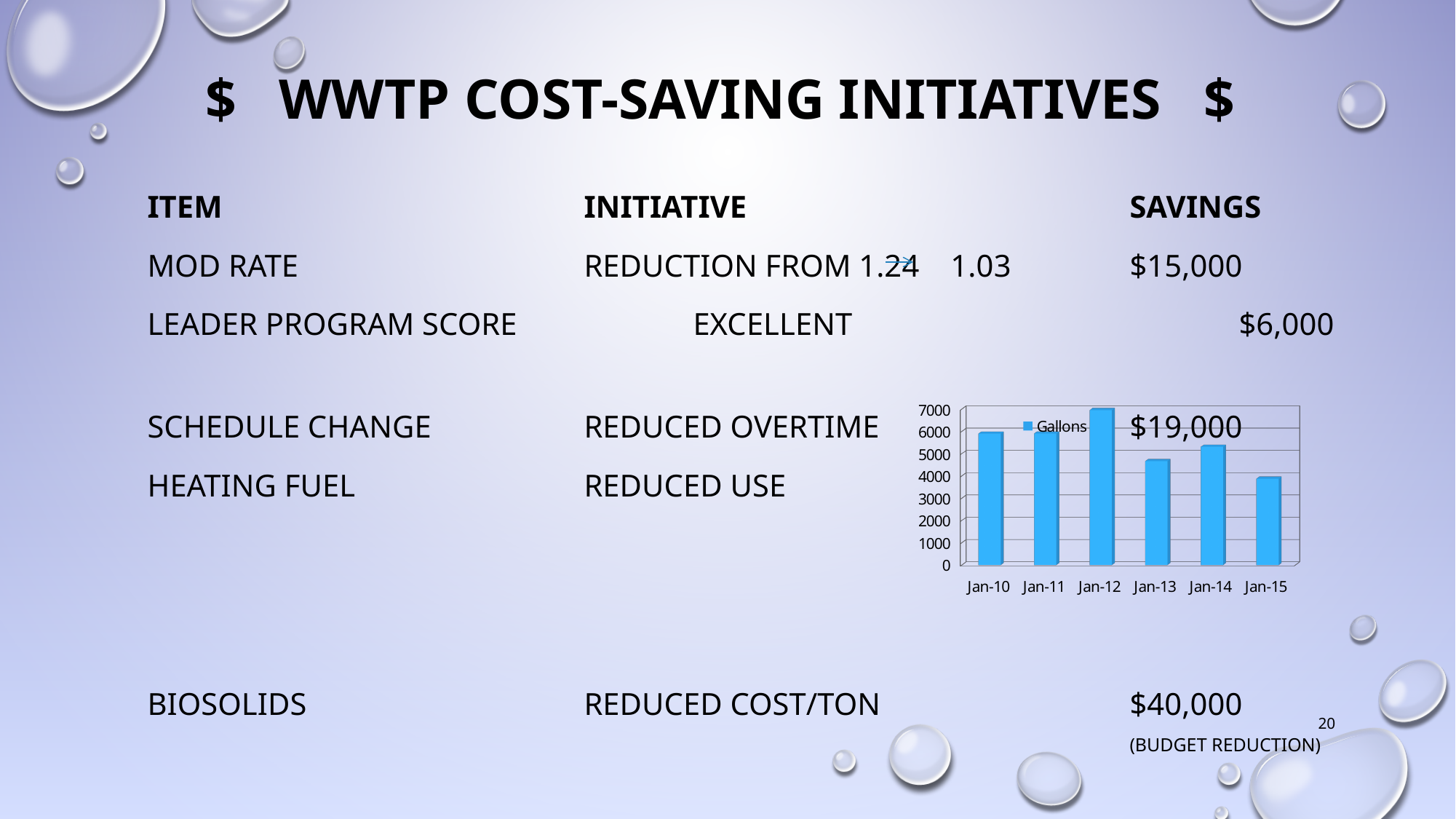
What is the name of the series shown in the chart's legend? Gallons How many bars (categories) does the chart show? 6 What kind of chart is shown on the slide? bar chart Which is larger, the value for Jan-12 or the value for Jan-13? Jan-12 Which category has the highest value in the chart? Jan-12 Which is larger, the value for Jan-14 or the value for Jan-15? Jan-14 Do the values rise or fall from Jan-12 to Jan-13? fall Is the value for Jan-12 greater or less than 6000? greater Is the value for Jan-13 greater or less than 5000? less How many series does the chart's legend list? 1 Which category has the lowest value in the chart? Jan-15